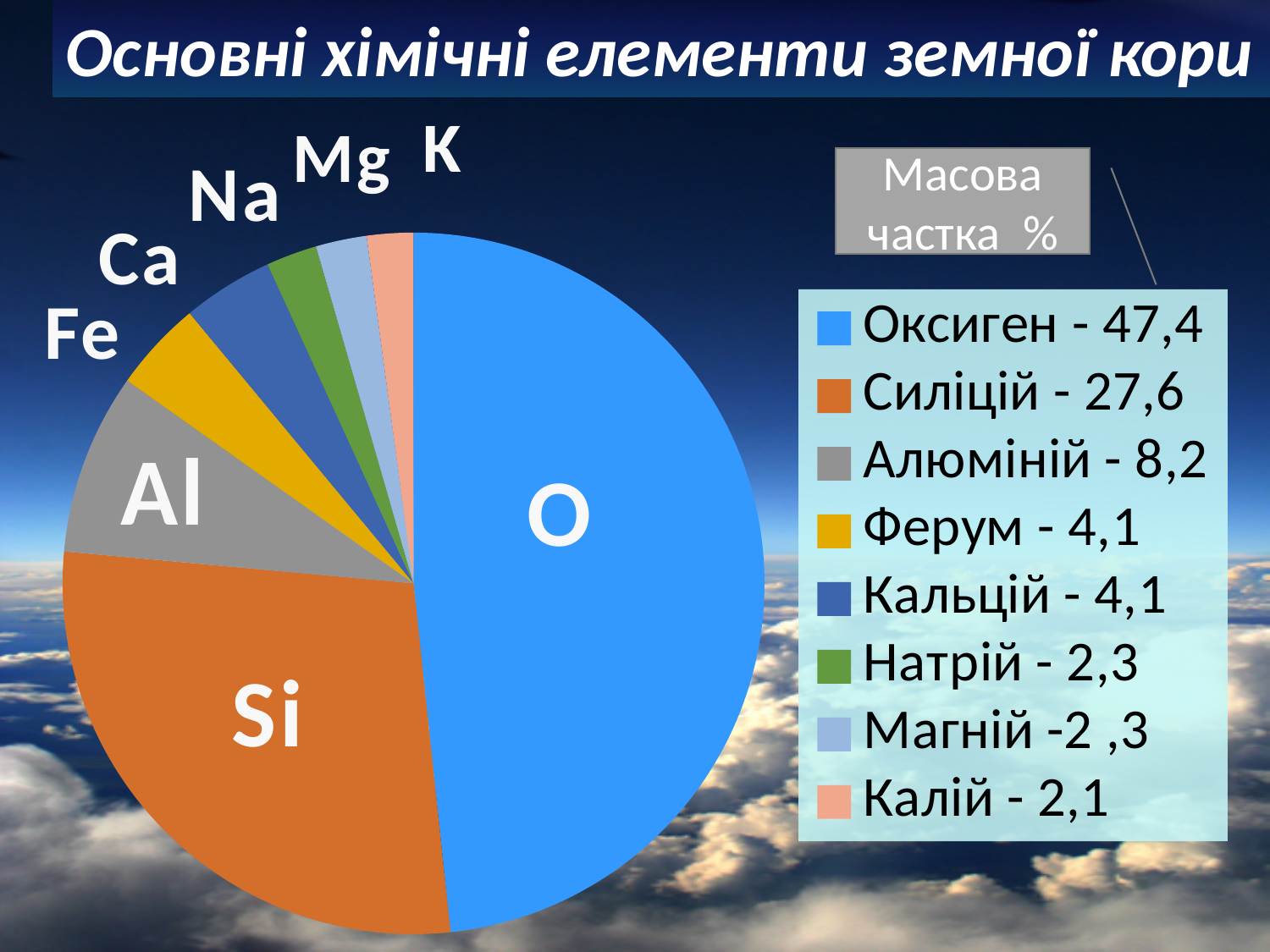
What colour is the slice for Ферум? Yellow What is the mass fraction (%) for Натрій? 2,3 Which is larger, the value for Силіцій or the value for Алюміній? Силіцій Which element has the largest slice of the pie? Оксиген What is the difference between the values for Оксиген and Силіцій? 19,8 What is the difference between the values for Алюміній and Ферум? 4,1 What is the mass fraction (%) for Силіцій? 27,6 Which element has the smallest slice of the pie? Калій What kind of chart is shown on the slide? Pie chart What is the mass fraction (%) for Алюміній? 8,2 What is the mass fraction (%) for Оксиген? 47,4 How many slices does the pie chart have? 8